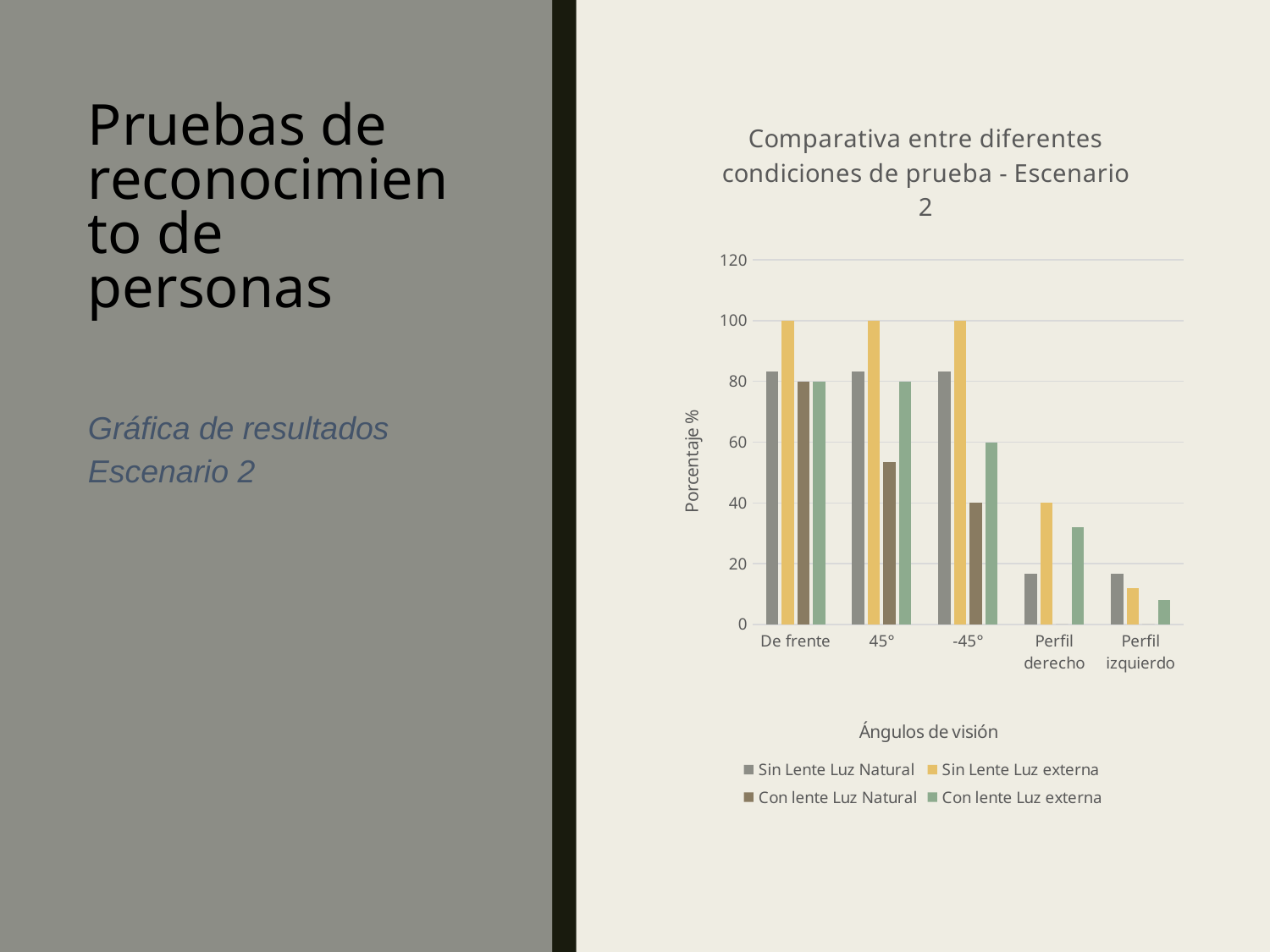
What is the value for Sin Lente Luz externa at Perfil derecho? 40 Is the value for Sin Lente Luz Natural at De frente greater or less than 80? greater What is the value for Con lente Luz externa at -45°? 60 Which category has the lowest value for Sin Lente Luz externa? Perfil izquierdo What is the title of the chart? Comparativa entre diferentes condiciones de prueba - Escenario 2 What is the value for Sin Lente Luz externa at De frente? 100 Is the value for Con lente Luz Natural at 45° greater or less than 60? less How many categories are shown on the x axis? 5 What is the label of the y axis? Porcentaje % Do the values for Sin Lente Luz externa rise or fall from De frente to Perfil izquierdo? fall How many series does the legend list? 4 What kind of chart is shown on the slide? bar chart